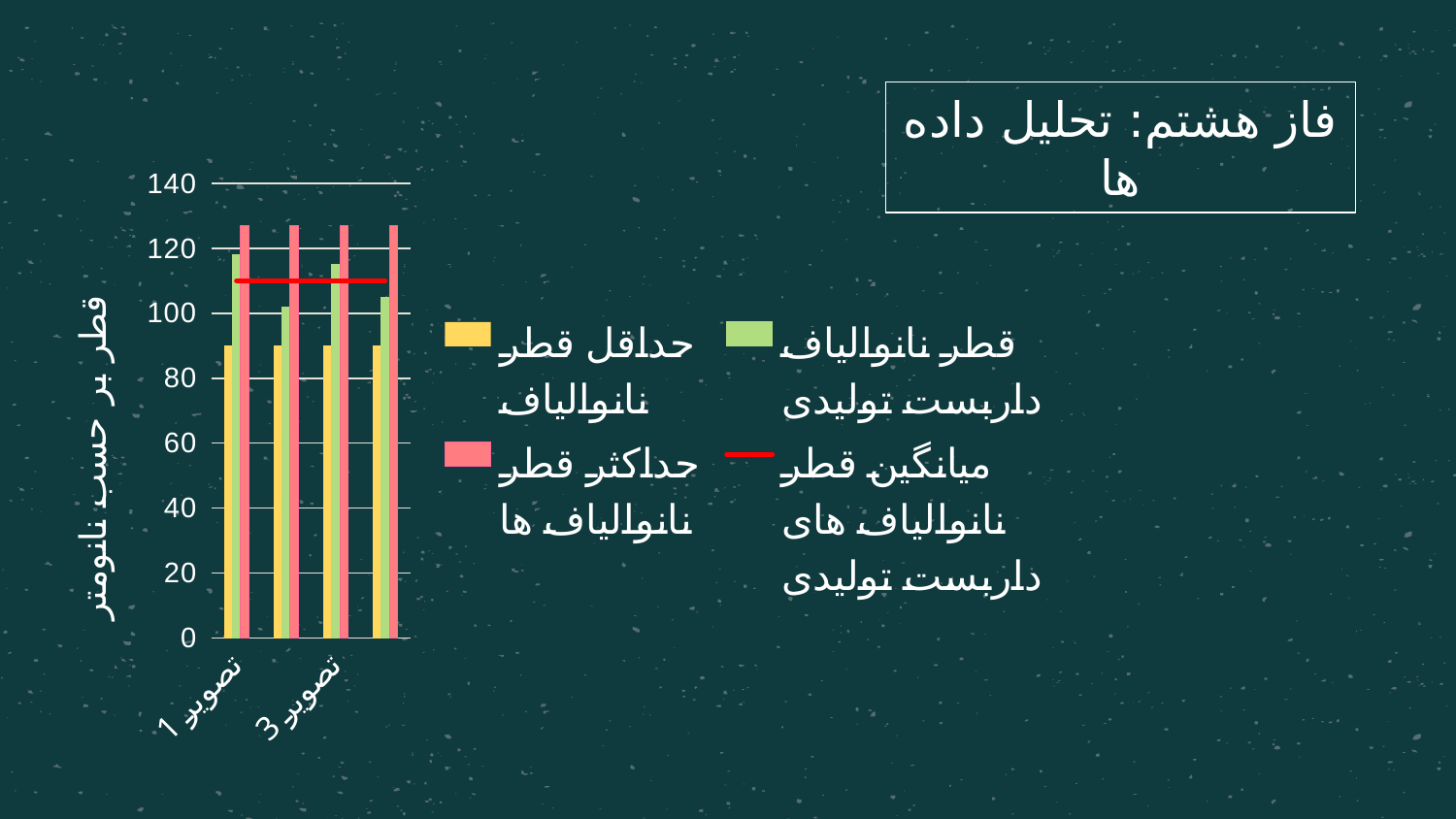
Is the value of 'حداقل قطر نانوالیاف' for تصویر 1 greater or less than 100? less How many series does the legend list? 4 Is the line 'میانگین قطر نانوالیاف های داربست تولیدی' greater or less than 100? greater Which colour represents the series 'حداکثر قطر نانوالیاف ها' in the legend? pink/red What kind of chart is shown on the slide? combination bar and line chart Is the line 'میانگین قطر نانوالیاف های داربست تولیدی' greater or less than 120? less For تصویر 1, which is larger: 'حداکثر قطر نانوالیاف ها' or 'حداقل قطر نانوالیاف'? حداکثر قطر نانوالیاف ها What is the title of the vertical axis? قطر بر حسب نانومتر What is the highest value shown on the vertical axis? 140